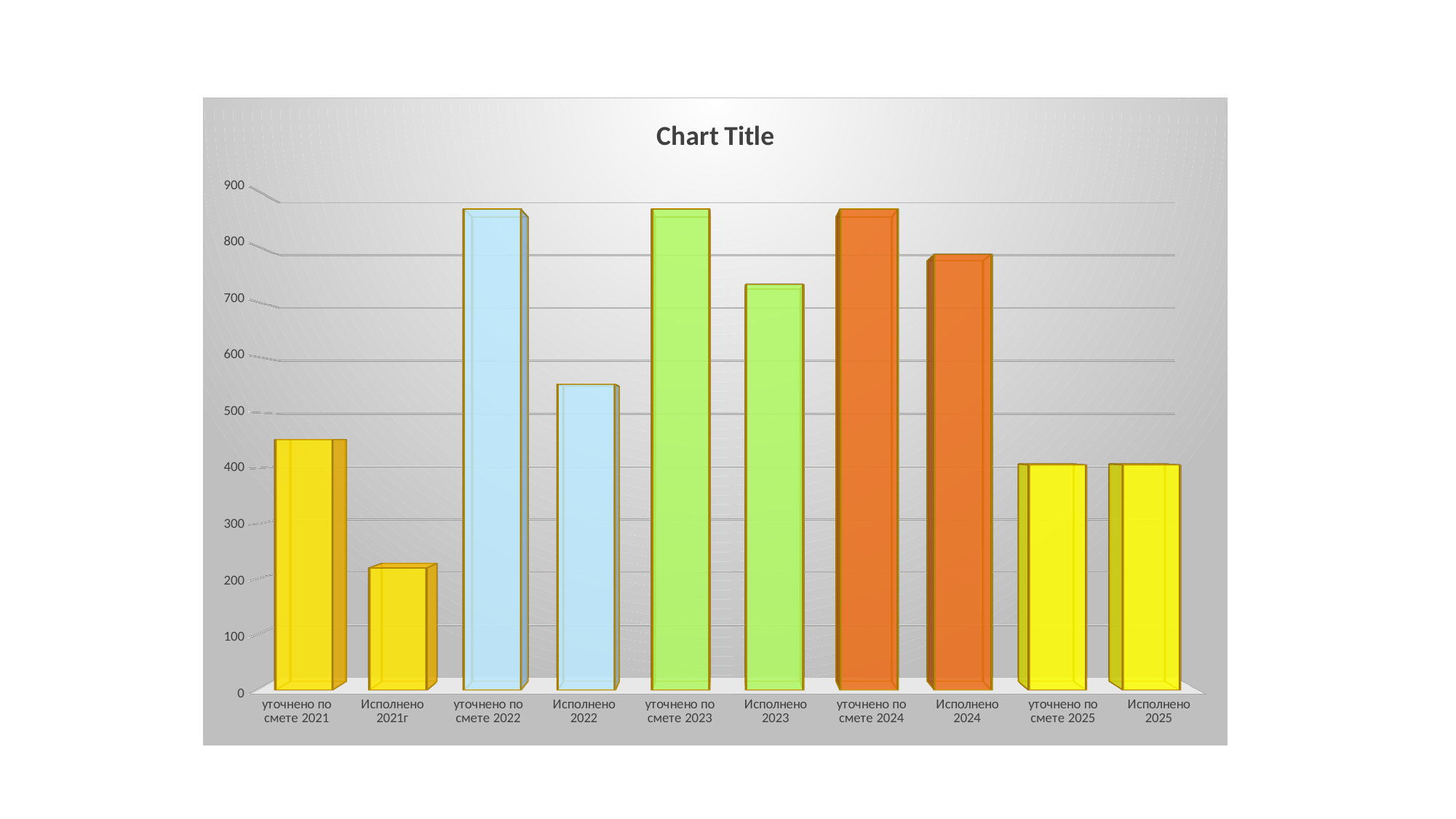
Which is larger, the value for уточнено по смете 2021 or the value for Исполнено 2021г? уточнено по смете 2021 Is the value for Исполнено 2021г greater or less than 300? less What kind of chart is shown on the slide? bar chart What is the title of the chart? Chart Title Which is larger, the value for уточнено по смете 2024 or the value for Исполнено 2024? уточнено по смете 2024 Which category has the lowest value? Исполнено 2021г Is the value for Исполнено 2023 greater or less than 800? less How many categories are plotted on the x axis? 10 Is the value for Исполнено 2022 greater or less than 500? greater Which is larger, the value for Исполнено 2022 or the value for Исполнено 2023? Исполнено 2023